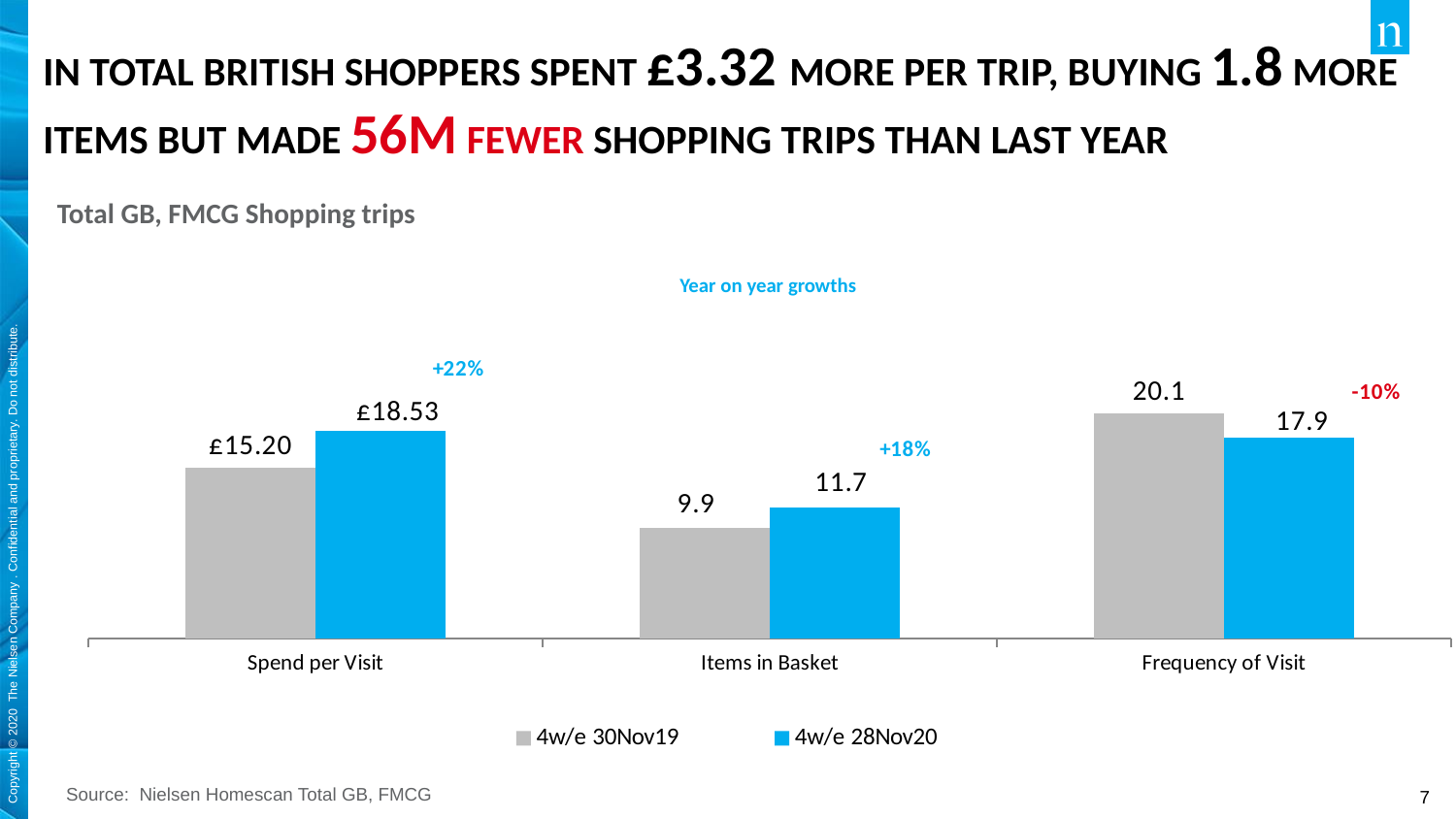
What is the value for Spend per Visit in the 4w/e 30Nov19 series? £15.20 How many series does the legend list? 2 What year-on-year growth is shown above the Frequency of Visit bars? -10% How many categories are shown on the x axis of the chart? 3 For Frequency of Visit, which series has the larger value, 4w/e 30Nov19 or 4w/e 28Nov20? 4w/e 30Nov19 For Items in Basket, which series has the larger value, 4w/e 30Nov19 or 4w/e 28Nov20? 4w/e 28Nov20 What kind of chart is shown on the slide? Bar chart What is the value for Items in Basket in the 4w/e 30Nov19 series? 9.9 What is the difference between the 4w/e 28Nov20 and 4w/e 30Nov19 values for Spend per Visit? £3.33 What is the value for Spend per Visit in the 4w/e 28Nov20 series? £18.53 What is the value for Frequency of Visit in the 4w/e 28Nov20 series? 17.9 What is the difference between the 4w/e 30Nov19 and 4w/e 28Nov20 values for Frequency of Visit? 2.2